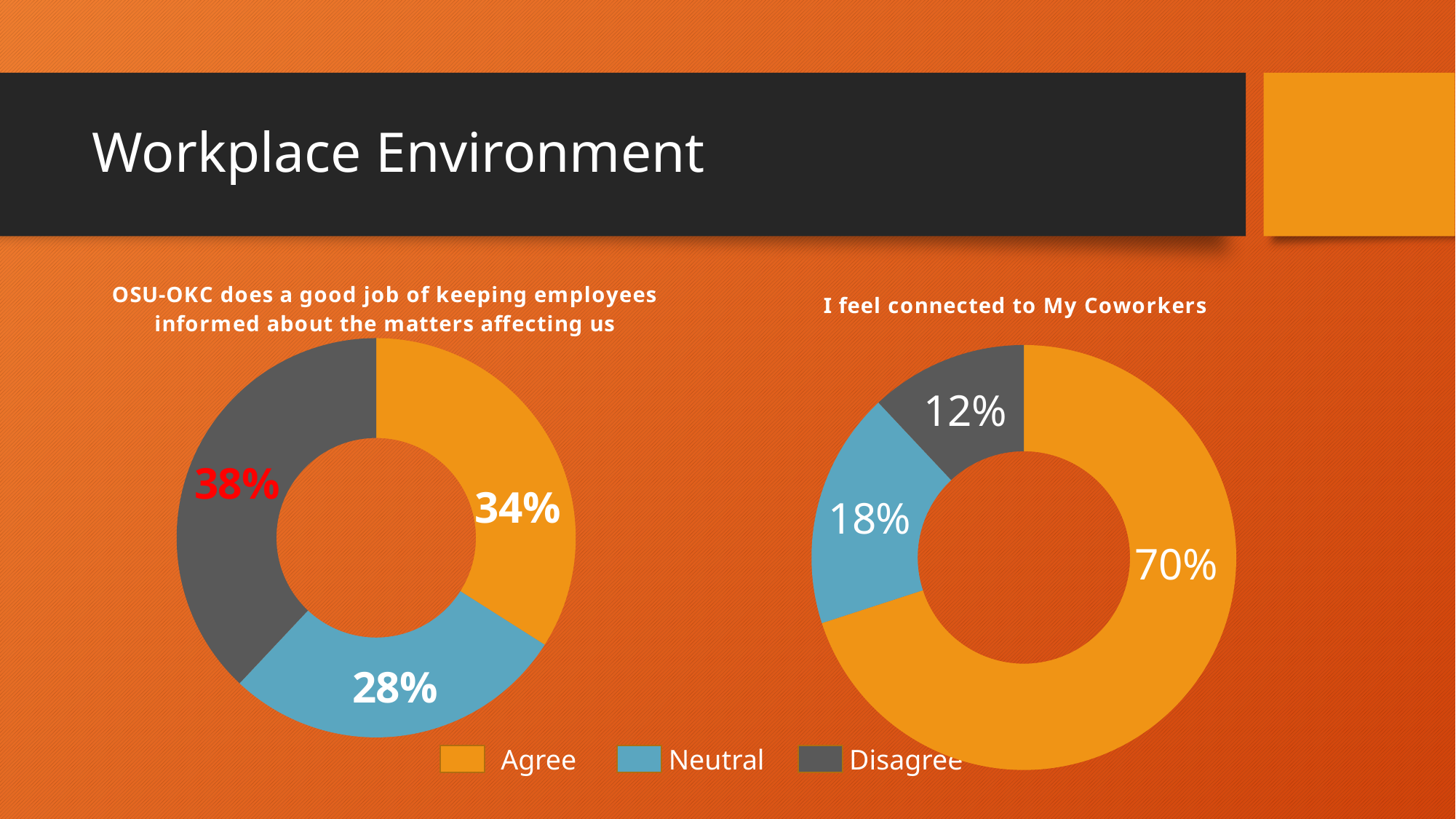
In the chart titled 'I feel connected to My Coworkers', what percentage of respondents chose Agree? 70% In the chart titled 'I feel connected to My Coworkers', which response has the smallest share? Disagree In the chart titled 'I feel connected to My Coworkers', what is the difference between the Agree and Neutral percentages? 52% In the chart titled 'OSU-OKC does a good job of keeping employees informed about the matters affecting us', what is the difference between the Disagree and Neutral percentages? 10% In the chart titled 'OSU-OKC does a good job of keeping employees informed about the matters affecting us', which response has the largest share? Disagree Which is larger: the Agree share in the left chart or the Agree share in the right chart? The right chart (70%) In the chart titled 'OSU-OKC does a good job of keeping employees informed about the matters affecting us', what percentage of respondents chose Disagree? 38% How many response categories does the legend list? 3 In the chart titled 'OSU-OKC does a good job of keeping employees informed about the matters affecting us', what percentage of respondents chose Agree? 34% Which colour represents Neutral in the legend? Blue In the chart titled 'I feel connected to My Coworkers', what percentage of respondents chose Neutral? 18% What type of chart is used on this slide? Doughnut (pie) chart